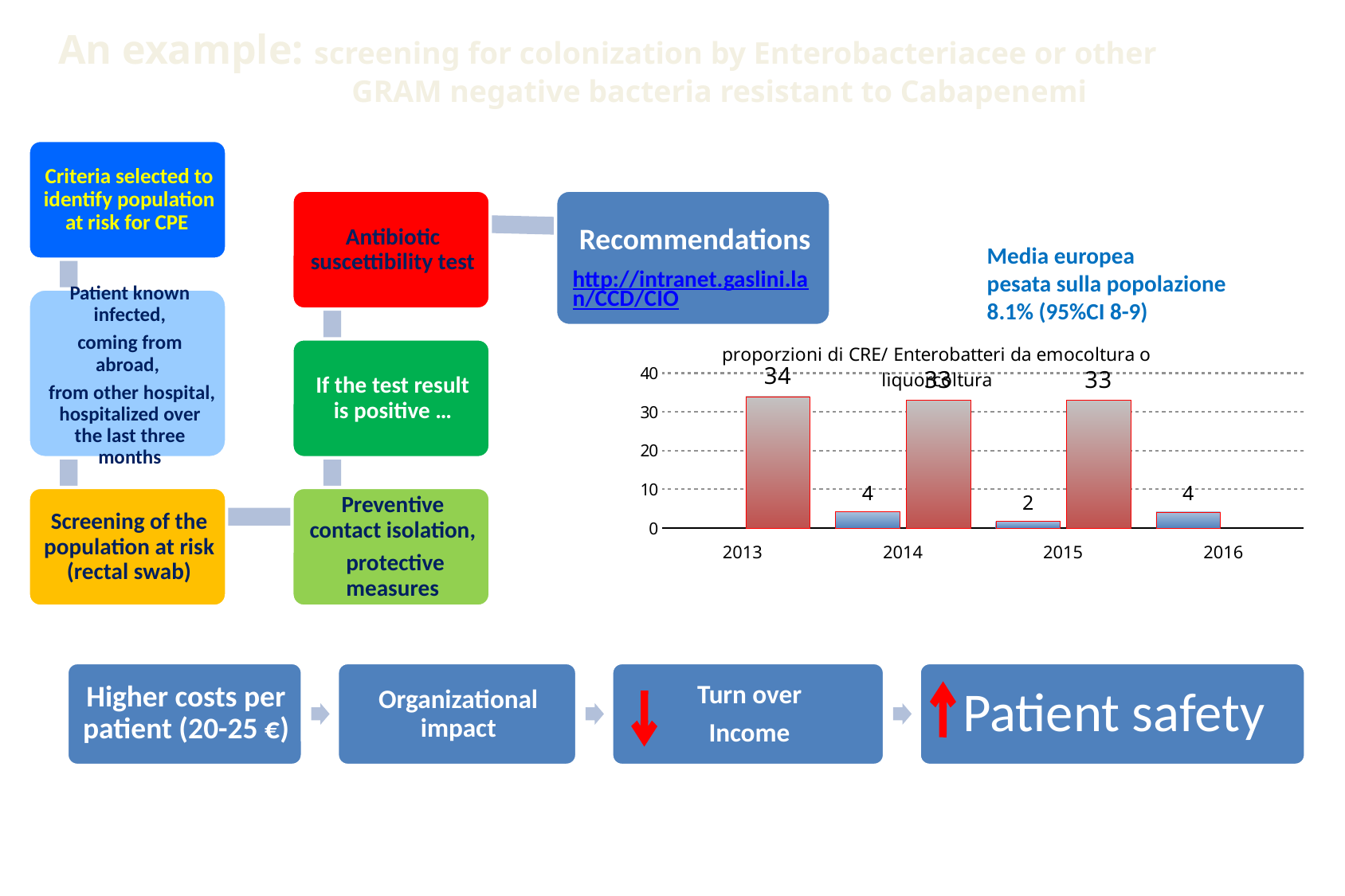
What is the highest value shown on the y axis of the chart? 40 Is the value of the tallest bar in the chart greater or less than 30? greater What is the title of the chart on the slide? proporzioni di CRE/ Enterobatteri da emocoltura o liquorcoltura Which is larger in the chart: the bar labelled 34 or the bar labelled 33? 34 What is the difference between the tallest bar (34) and the shortest bar (2) in the chart? 32 How many years are labelled on the x axis of the chart? 4 How many red bars are there in the chart? 3 What is the value shown on the shortest bar in the chart? 2 What is the value shown on the tallest bar in the chart? 34 Are the blue bars in the chart greater or less than 10? less How many bars are plotted in the chart? 6 What kind of chart is shown on the slide? bar chart